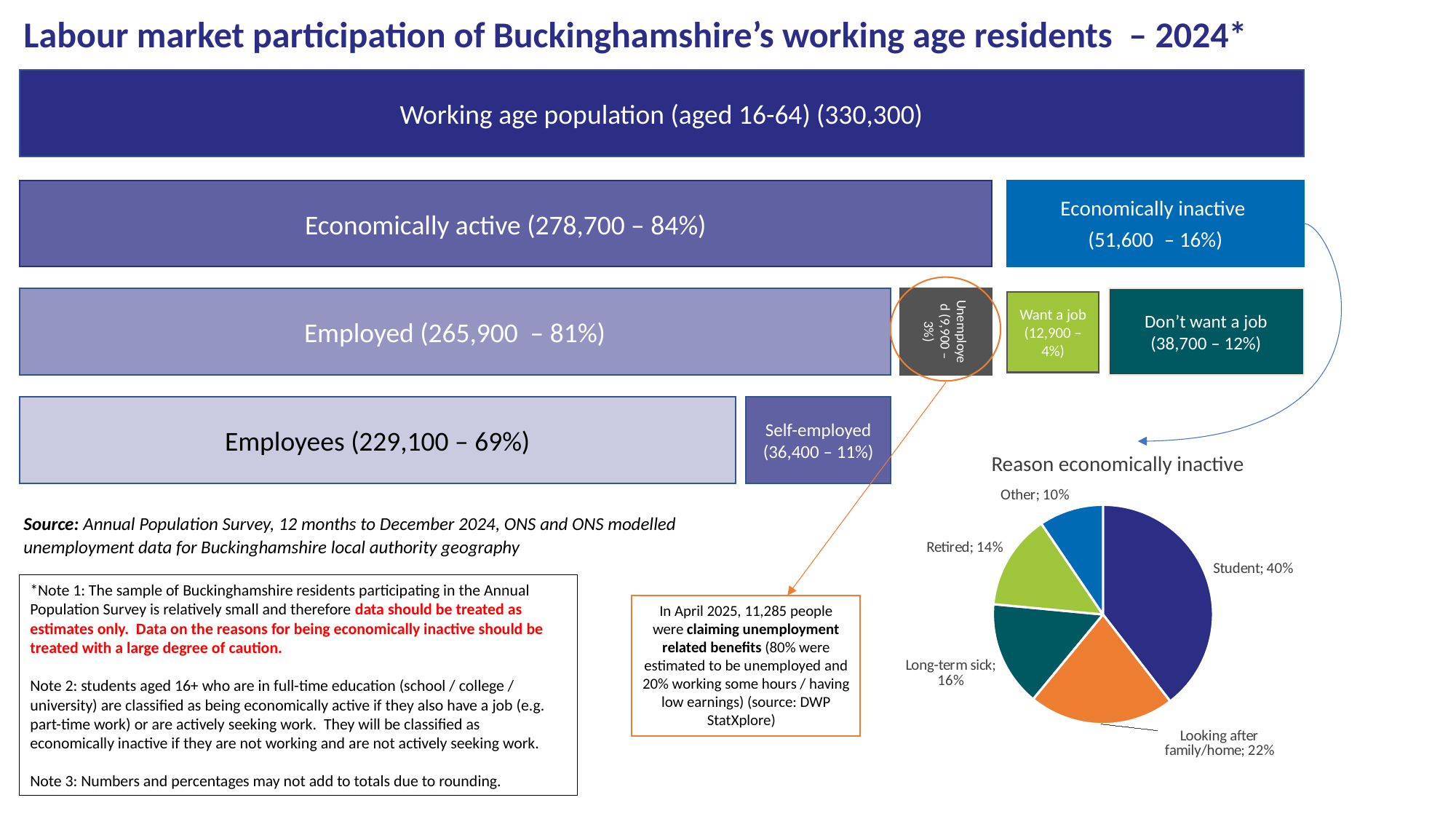
In the pie chart, which is larger: the Retired share or the Long-term sick share? Long-term sick In the pie chart, what share is labelled for Retired? 14% What is the title of the pie chart? Reason economically inactive Which reason has the smallest slice in the pie chart? Other In the pie chart, what share is labelled for Looking after family/home? 22% How many slices does the pie chart have? 5 In the pie chart, what share is labelled for Other? 10% In the pie chart, how many percentage points larger is the Student share than the Looking after family/home share? 18 In the pie chart, what share is labelled for Student? 40% In the pie chart, what share is labelled for Long-term sick? 16% What kind of chart is used to show the reasons for being economically inactive? pie chart Which reason has the largest slice in the pie chart? Student